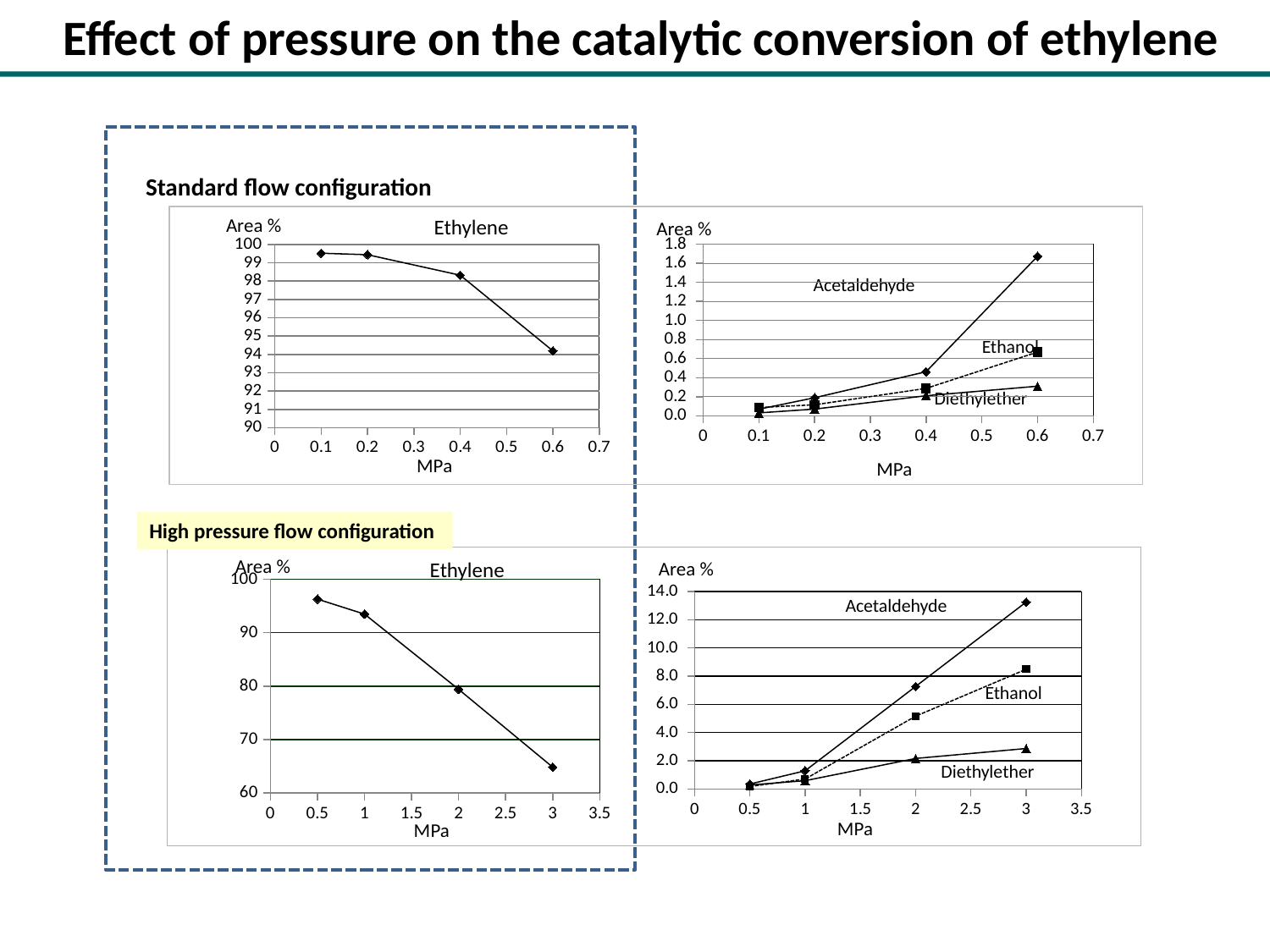
How many data points are plotted in the top-left Ethylene chart (Standard flow configuration)? 4 In the top-right chart (Standard flow configuration), which series has the highest value at 0.6 MPa? Acetaldehyde In the top-left Ethylene chart (Standard flow configuration), does the Ethylene area % rise or fall as pressure (MPa) increases? Fall In the top-right chart (Standard flow configuration), is the Acetaldehyde value at 0.6 MPa greater or less than 1.4? greater What is the y-axis label shown on the bottom-right chart (High pressure flow configuration)? Area % In the bottom-left Ethylene chart (High pressure flow configuration), is the value at 0.5 MPa greater or less than 90? greater What kind of chart is the top-left Ethylene chart under Standard flow configuration? Line chart In the bottom-right chart (High pressure flow configuration), which series has the lowest value at 3 MPa? Diethylether In the top-left Ethylene chart (Standard flow configuration), is the value at 0.6 MPa greater or less than 95? less In the bottom-right chart (High pressure flow configuration), which is larger at 2 MPa: Ethanol or Diethylether? Ethanol How many series are plotted in the top-right chart (Standard flow configuration)? 3